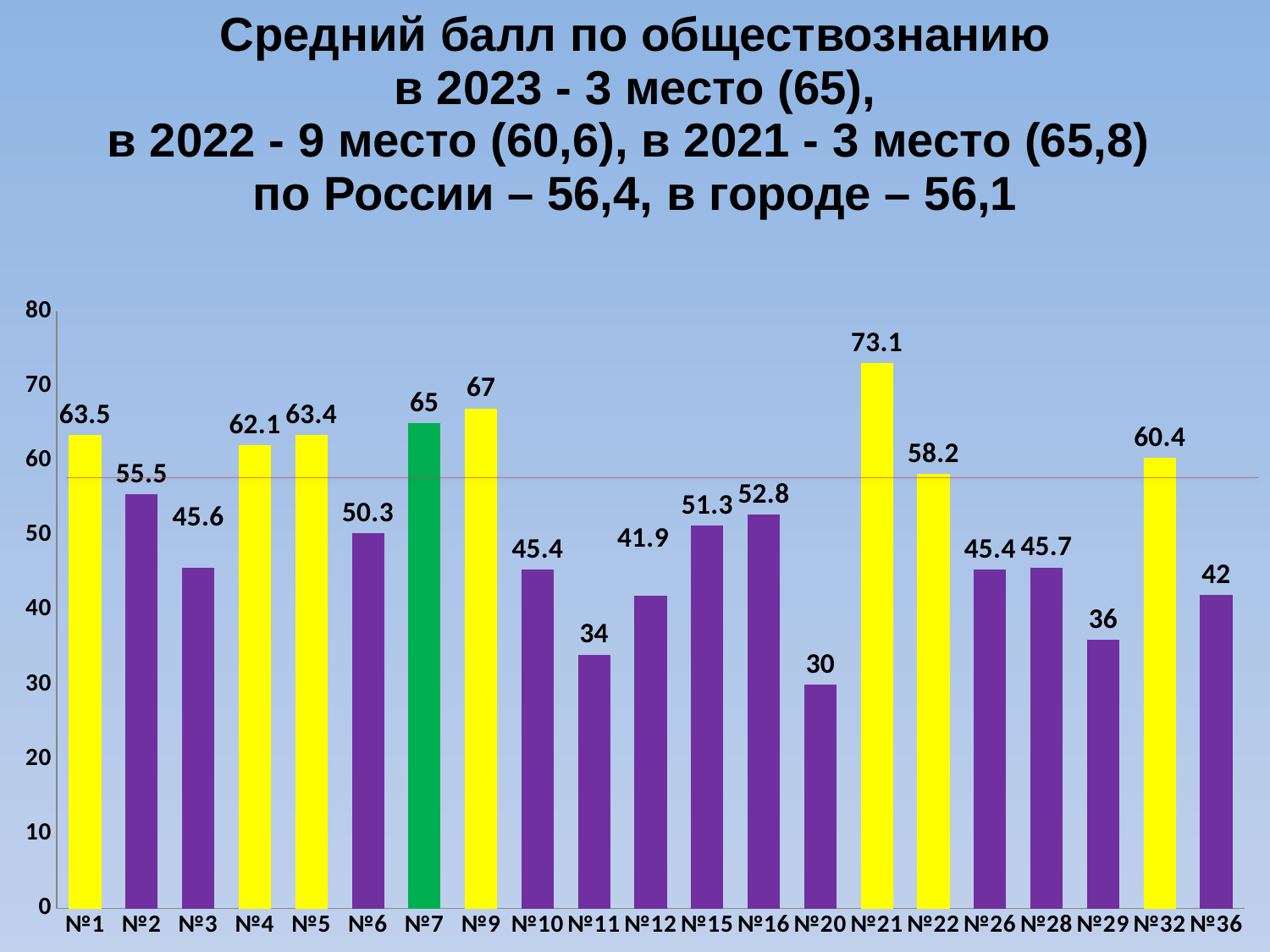
Is the value for №11 greater or less than 40? less What is the value for №20? 30 What kind of chart is shown on the slide? bar chart What is the difference between the values for №1 and №2? 8 What is the value for №7, the green bar? 65 Which category has the highest value? №21 What is the value for №21? 73.1 What is the difference between the values for №21 and №20? 43.1 How many categories are shown on the x axis? 21 Which category has the lowest value? №20 Which is larger, the value for №9 or the value for №32? №9 What colour is the bar for №7? green